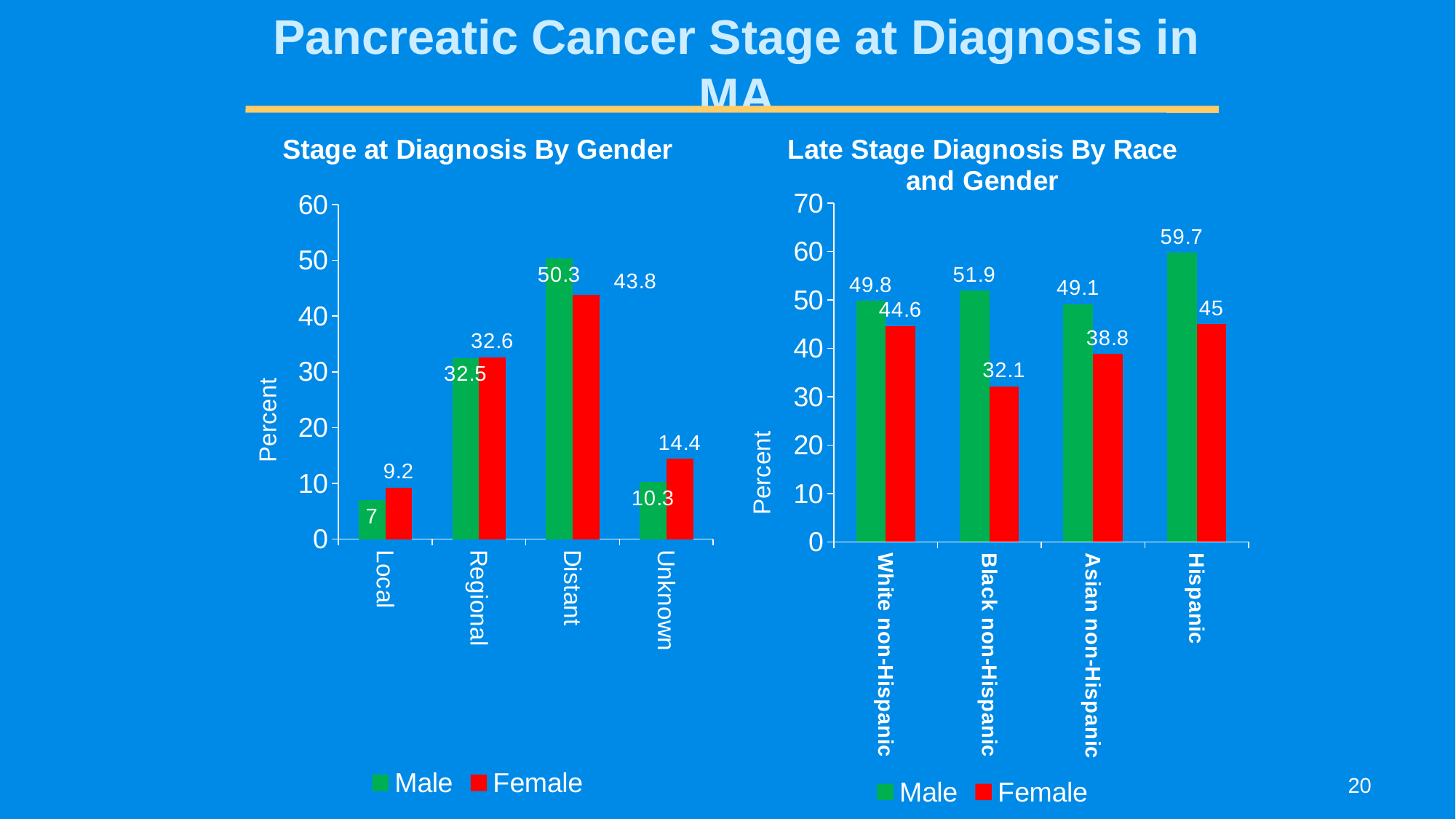
In the 'Late Stage Diagnosis By Race and Gender' chart, is the Male value for White non-Hispanic larger or the Female value for White non-Hispanic? Male In the 'Stage at Diagnosis By Gender' chart, how many stage categories are shown on the x axis? 4 How many series does the legend of the 'Late Stage Diagnosis By Race and Gender' chart list? 2 In the 'Late Stage Diagnosis By Race and Gender' chart, what is the Female value for Black non-Hispanic? 32.1 In the 'Late Stage Diagnosis By Race and Gender' chart, which race group has the highest Male value? Hispanic In the 'Stage at Diagnosis By Gender' chart, which stage has the highest Female value? Distant In the 'Late Stage Diagnosis By Race and Gender' chart, what is the difference between the Male and Female values for Hispanic? 14.7 In the 'Stage at Diagnosis By Gender' chart, what is the Female value for Unknown? 14.4 In the 'Stage at Diagnosis By Gender' chart, what is the Male value for Distant? 50.3 In the 'Stage at Diagnosis By Gender' chart, what is the difference between the Male and Female values for Distant? 6.5 In the 'Late Stage Diagnosis By Race and Gender' chart, which race group has the lowest Female value? Black non-Hispanic In the 'Stage at Diagnosis By Gender' chart, which stage has the lowest Male value? Local